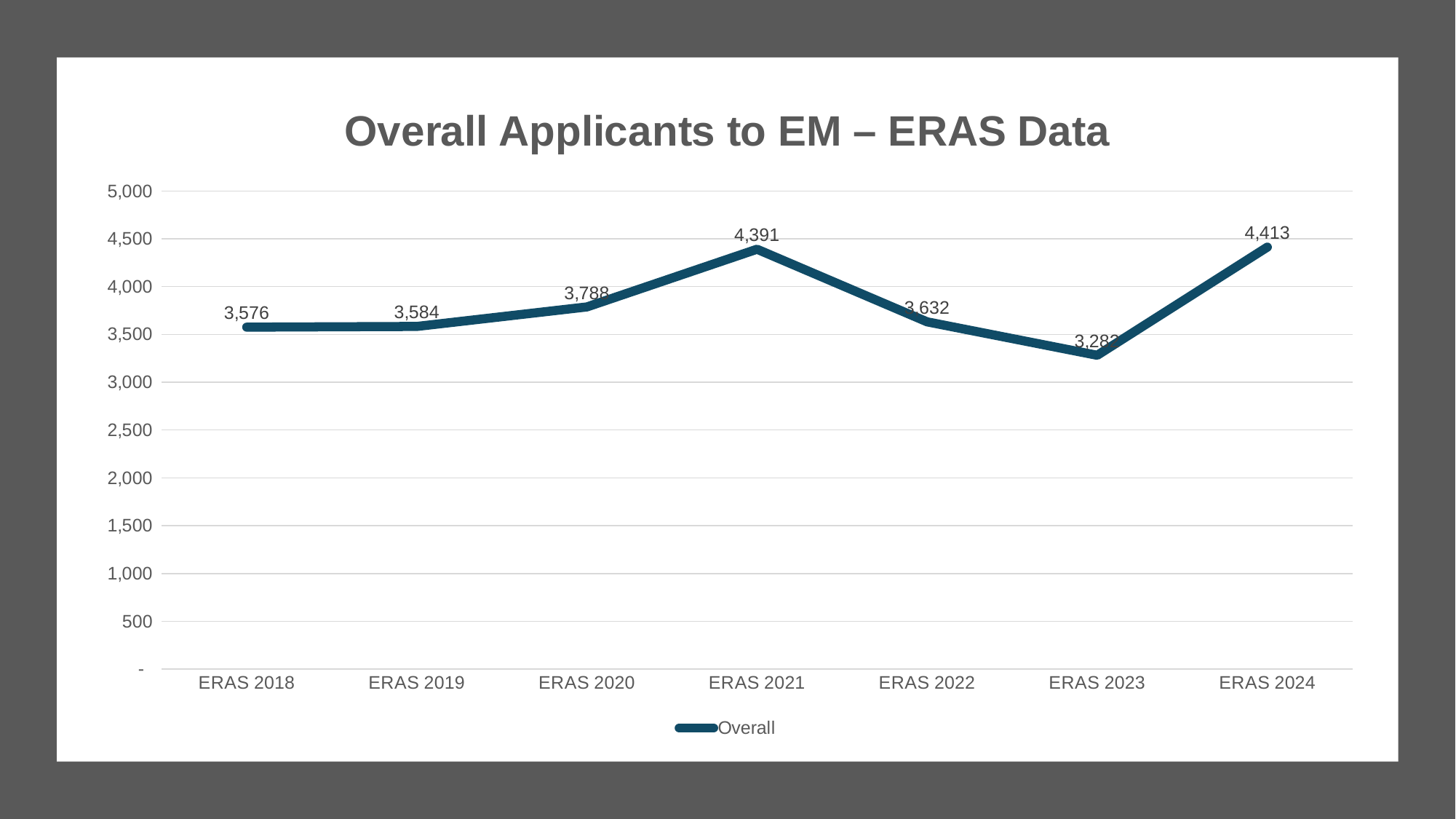
What is the difference between the values for ERAS 2021 and ERAS 2020? 603 How many years are plotted on the x axis? 7 Which year has the highest number of applicants? ERAS 2024 What is the value for ERAS 2021? 4,391 Is the value for ERAS 2023 greater or less than 3,500? less What kind of chart is shown on the slide? line chart Do the values rise or fall from ERAS 2021 to ERAS 2023? fall How many series does the legend list? 1 Which year has the lowest number of applicants? ERAS 2023 What is the value for ERAS 2024? 4,413 Which is larger, the value for ERAS 2019 or the value for ERAS 2022? ERAS 2022 What is the value for ERAS 2018? 3,576